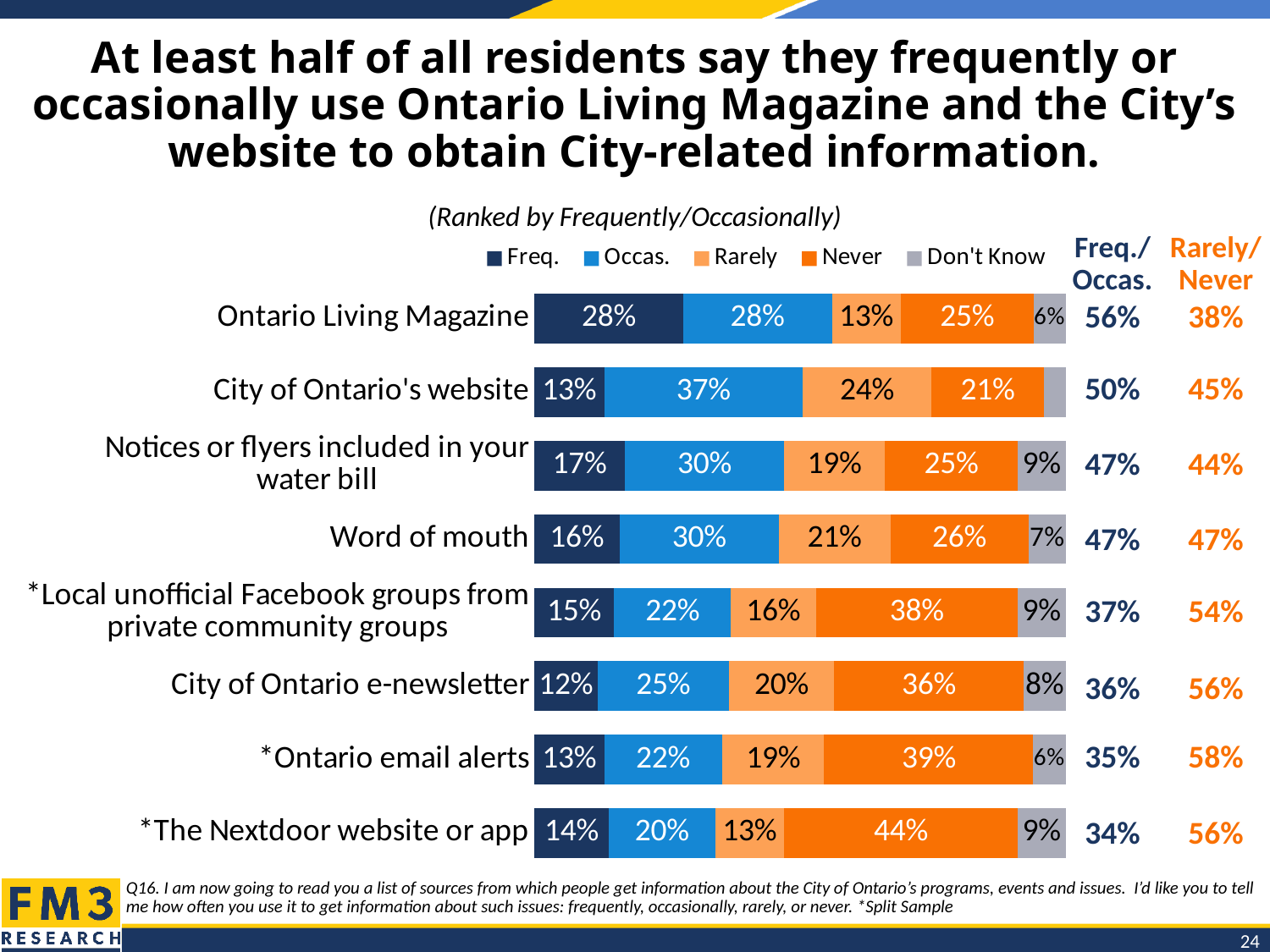
Which legend entry is shown in dark navy blue? Freq. How many sources are listed in the chart? 8 What is the combined Freq./Occas. total for Ontario Living Magazine? 56% What is the Occas. value for City of Ontario's website? 37% What percentage of residents say they never use the Nextdoor website or app? 44% Which source has the lowest Freq. percentage? City of Ontario e-newsletter Which source has the highest Never percentage? The Nextdoor website or app How many series does the legend list? 5 What is the difference between the Never percentages for Ontario email alerts and Word of mouth? 13% Which is larger: the Rarely value for City of Ontario's website or the Rarely value for Notices or flyers included in your water bill? City of Ontario's website What kind of chart is shown on the slide? Stacked bar chart What percentage of residents say they frequently use Ontario Living Magazine? 28%